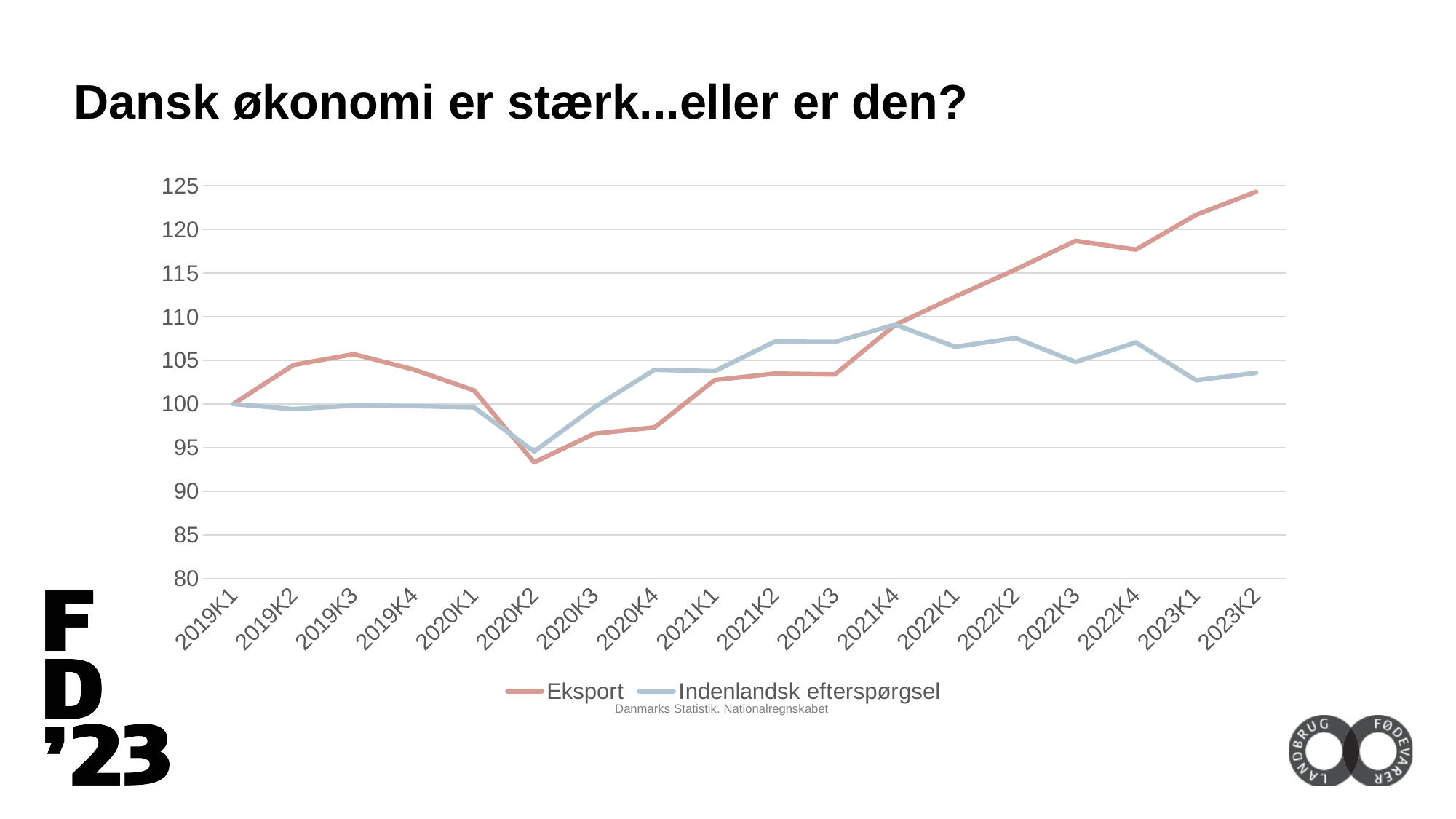
What is the value of Eksport at 2019K1? 100 In which quarter does Eksport reach its lowest value? 2020K2 Is the value for Indenlandsk efterspørgsel at 2023K2 greater or less than 105? less Is the value for Eksport at 2020K2 greater or less than 95? less What kind of chart is shown on the slide? Line chart What is the title of the slide? Dansk økonomi er stærk...eller er den? At 2021K2, which series has the higher value, Eksport or Indenlandsk efterspørgsel? Indenlandsk efterspørgsel In which quarter does Eksport reach its highest value? 2023K2 How many quarters are plotted along the x axis? 18 Is the value for Eksport at 2023K2 greater or less than 120? greater Does Eksport rise or fall from 2022K4 to 2023K2? Rise How many series does the legend list? 2